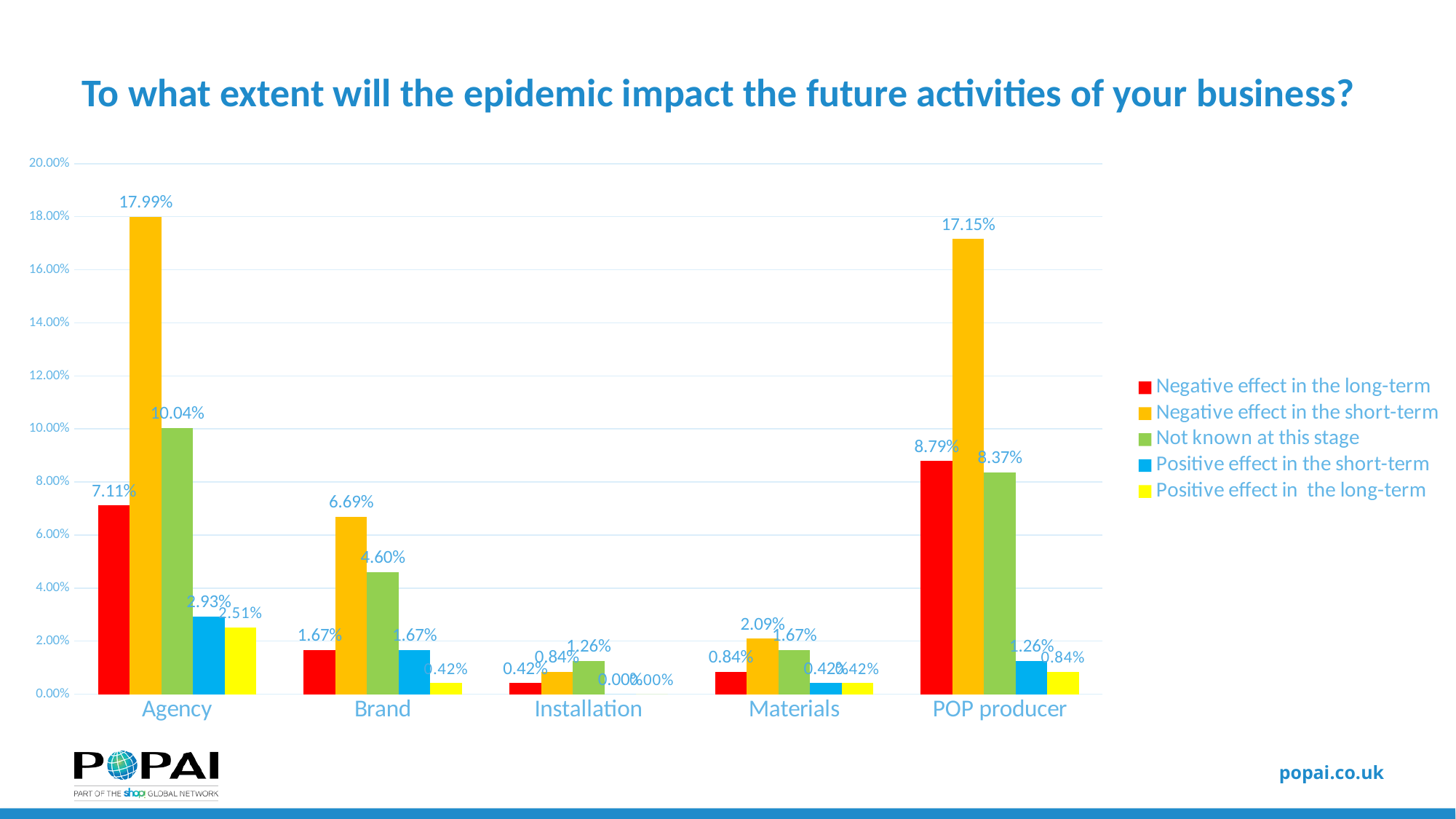
Is the value for 'Not known at this stage' for Agency greater or less than 8.00%? greater What is the value for 'Negative effect in the short-term' for Agency? 17.99% Which category has the lowest value for 'Negative effect in the long-term'? Installation What is the value for 'Not known at this stage' for Installation? 1.26% Which category has the highest value for 'Negative effect in the short-term'? Agency What is the difference between the 'Negative effect in the short-term' values for Agency and POP producer? 0.84% How many series does the legend list? 5 How many categories are shown on the x axis? 5 What kind of chart is shown on the slide? Bar chart Which is larger: 'Negative effect in the long-term' for POP producer or for Agency? POP producer What is the value for 'Negative effect in the long-term' for Brand? 1.67% What is the value for 'Not known at this stage' for POP producer? 8.37%